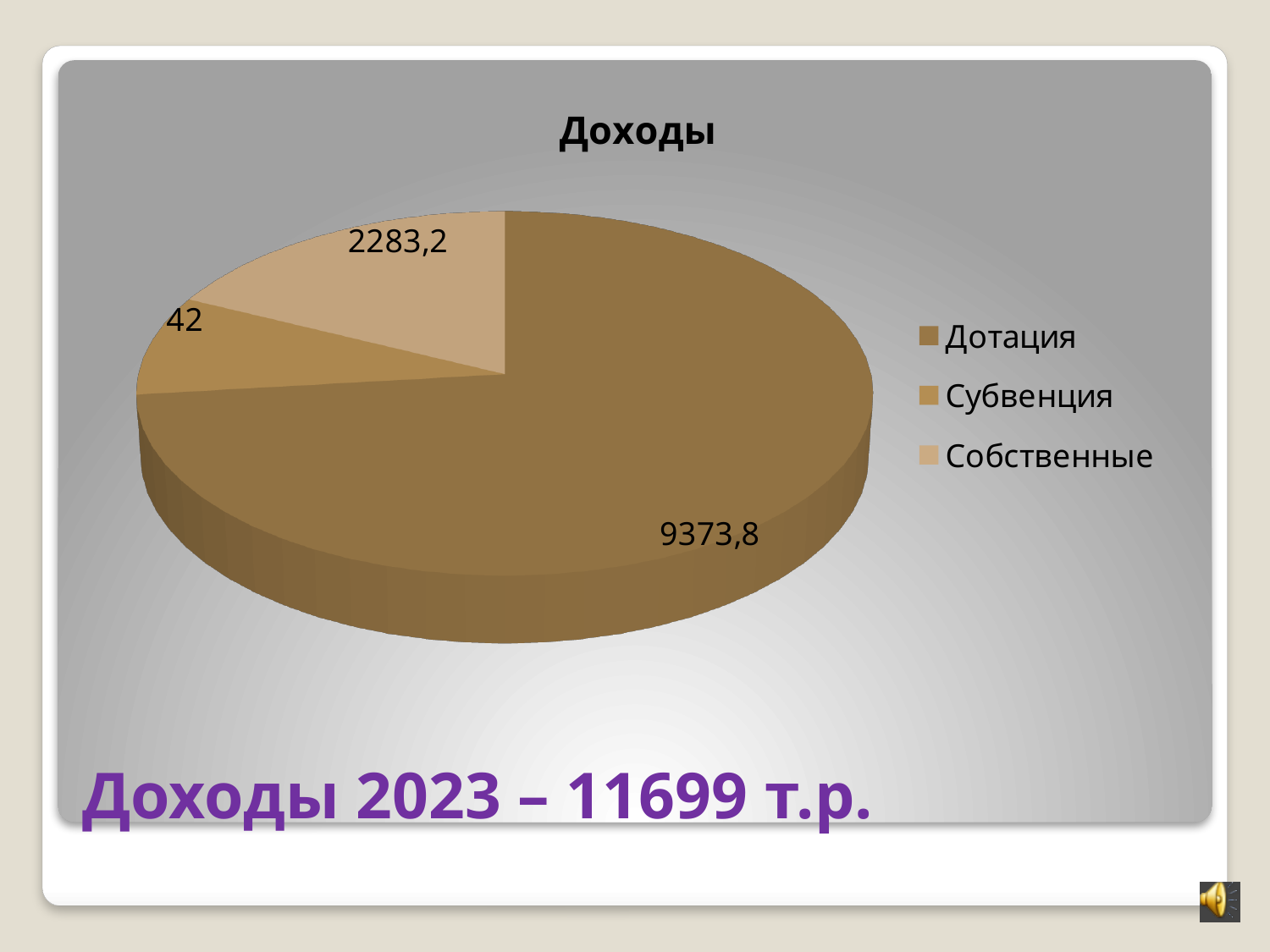
Which category has the largest slice in the Доходы pie chart? Дотация What is the total of all slices in the Доходы pie chart? 11699 What is the value of the Собственные slice in the Доходы pie chart? 2283,2 How many slices does the Доходы pie chart have? 3 What is the difference between the Дотация and Собственные values in the Доходы pie chart? 7090,6 What type of chart is shown on the slide? Pie chart What is the value of the Субвенция slice in the Доходы pie chart? 42 Which is larger in the Доходы pie chart, Собственные or Субвенция? Собственные What is the value of the Дотация slice in the Доходы pie chart? 9373,8 What is the title of the chart on the slide? Доходы What is the difference between the Собственные and Субвенция values in the Доходы pie chart? 2241,2 Which category has the smallest slice in the Доходы pie chart? Субвенция